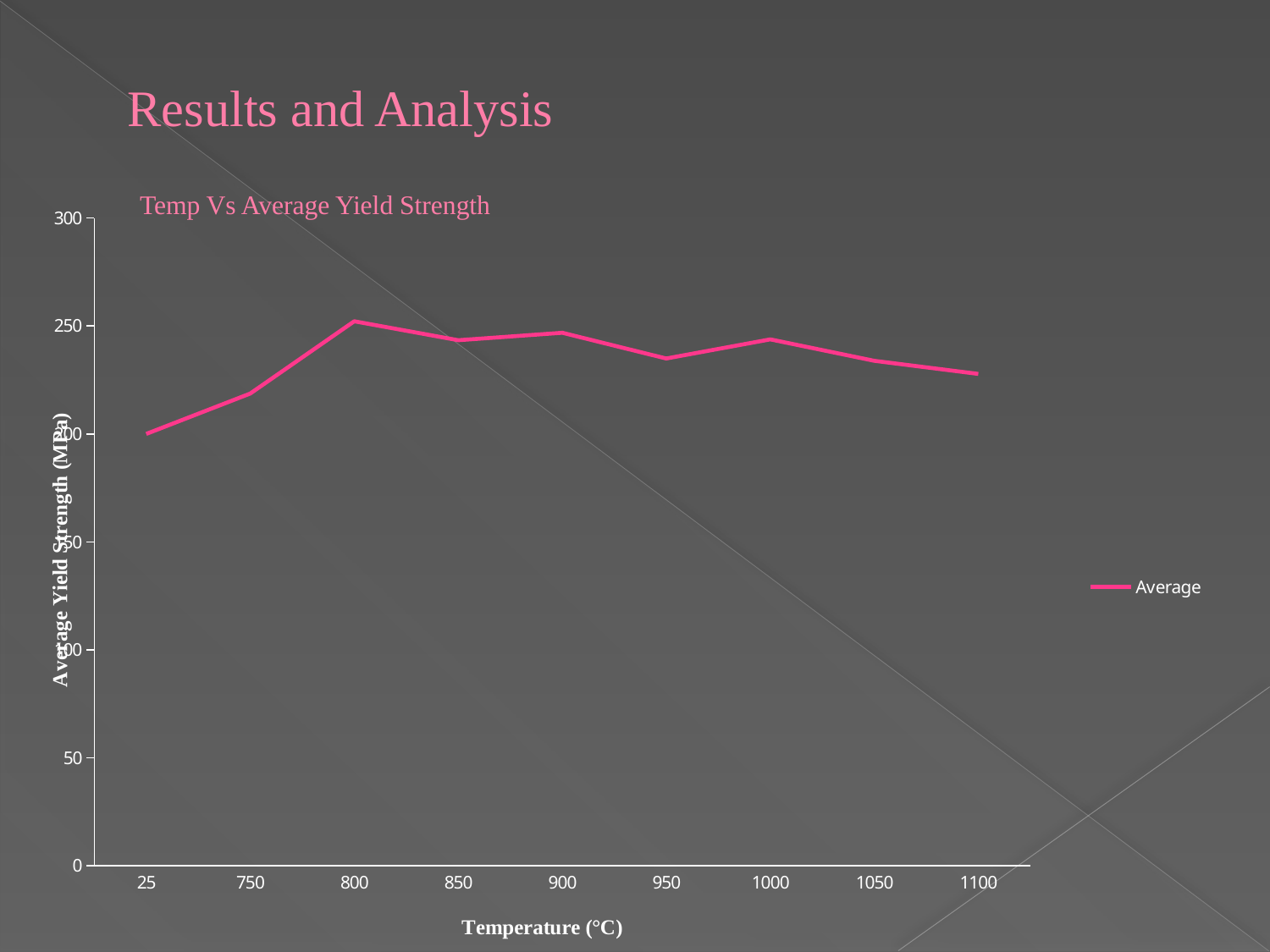
At which temperature is the average yield strength highest? 800 How many temperature points are plotted on the x axis? 9 How many series does the legend list? 1 Is the average yield strength at 25 °C greater or less than 250? less What kind of chart is shown on the slide? line chart Which has the higher average yield strength, 800 °C or 1100 °C? 800 Does the average yield strength rise or fall from 800 °C to 1100 °C? fall At which temperature is the average yield strength lowest? 25 Is the average yield strength at 1100 °C greater or less than 250? less Is the average yield strength at 750 °C greater or less than 200? greater What is the title of the chart? Temp Vs Average Yield Strength What is the name of the series shown in the legend? Average